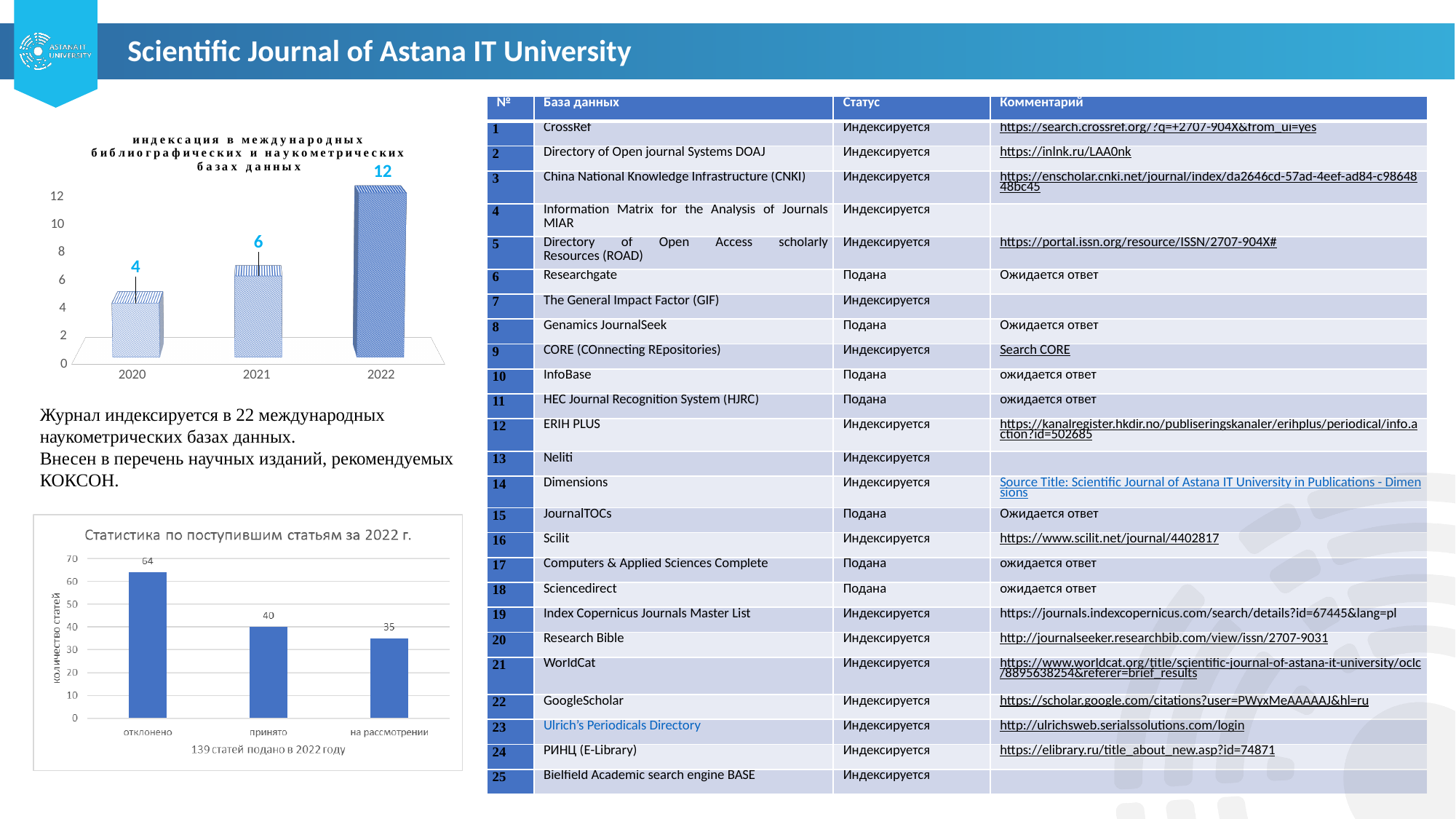
In the top-left chart on indexing in international databases, which year has the highest value? 2022 In the top-left chart on indexing in international databases, what is the difference between the 2022 and 2021 values? 6 In the bottom-left chart 'Статистика по поступившим статьям за 2022 г.', what is the value for 'отклонено'? 64 In the bottom-left chart 'Статистика по поступившим статьям за 2022 г.', what is the value for 'на рассмотрении'? 35 In the bottom-left chart 'Статистика по поступившим статьям за 2022 г.', which is larger: 'принято' or 'на рассмотрении'? принято In the top-left chart on indexing in international databases, what is the value for 2020? 4 In the top-left chart on indexing in international databases, how many years are shown? 3 In the top-left chart on indexing in international databases, do the values rise or fall from 2020 to 2022? rise In the bottom-left chart 'Статистика по поступившим статьям за 2022 г.', which category has the lowest value? на рассмотрении In the bottom-left chart 'Статистика по поступившим статьям за 2022 г.', what is the difference between 'отклонено' and 'принято'? 24 In the top-left chart on indexing in international databases, what is the value for 2022? 12 What type of chart is the bottom-left chart 'Статистика по поступившим статьям за 2022 г.'? bar chart